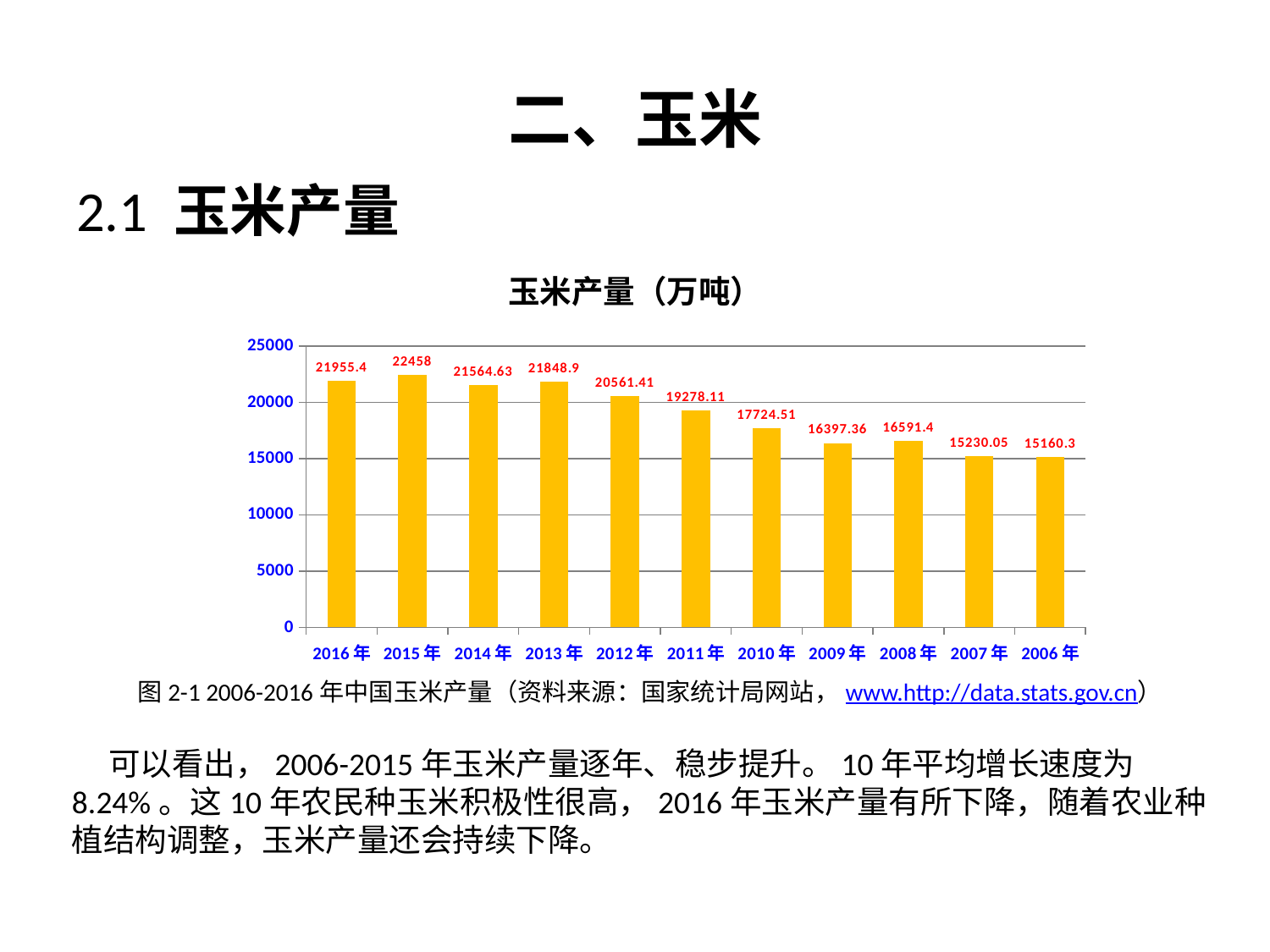
Do the values in the 玉米产量（万吨） chart generally rise or fall from left to right along the x axis? fall What is the difference between the corn output for 2012 年 and 2011 年 in the 玉米产量（万吨） chart? 1283.3 What is the corn output value shown for 2006 年 in the 玉米产量（万吨） chart? 15160.3 What is the corn output value shown for 2012 年 in the 玉米产量（万吨） chart? 20561.41 In the 玉米产量（万吨） chart, is the value for 2011 年 greater or less than 20000? less Which year has the lowest corn output in the 玉米产量（万吨） chart? 2006 年 What is the difference between the corn output for 2015 年 and 2016 年 in the 玉米产量（万吨） chart? 502.6 How many years are shown in the 玉米产量（万吨） chart? 11 In the 玉米产量（万吨） chart, which year has the larger corn output, 2013 年 or 2014 年? 2013 年 What is the corn output value shown for 2015 年 in the 玉米产量（万吨） chart? 22458 What kind of chart is the 玉米产量（万吨） chart? bar chart Which year has the highest corn output in the 玉米产量（万吨） chart? 2015 年